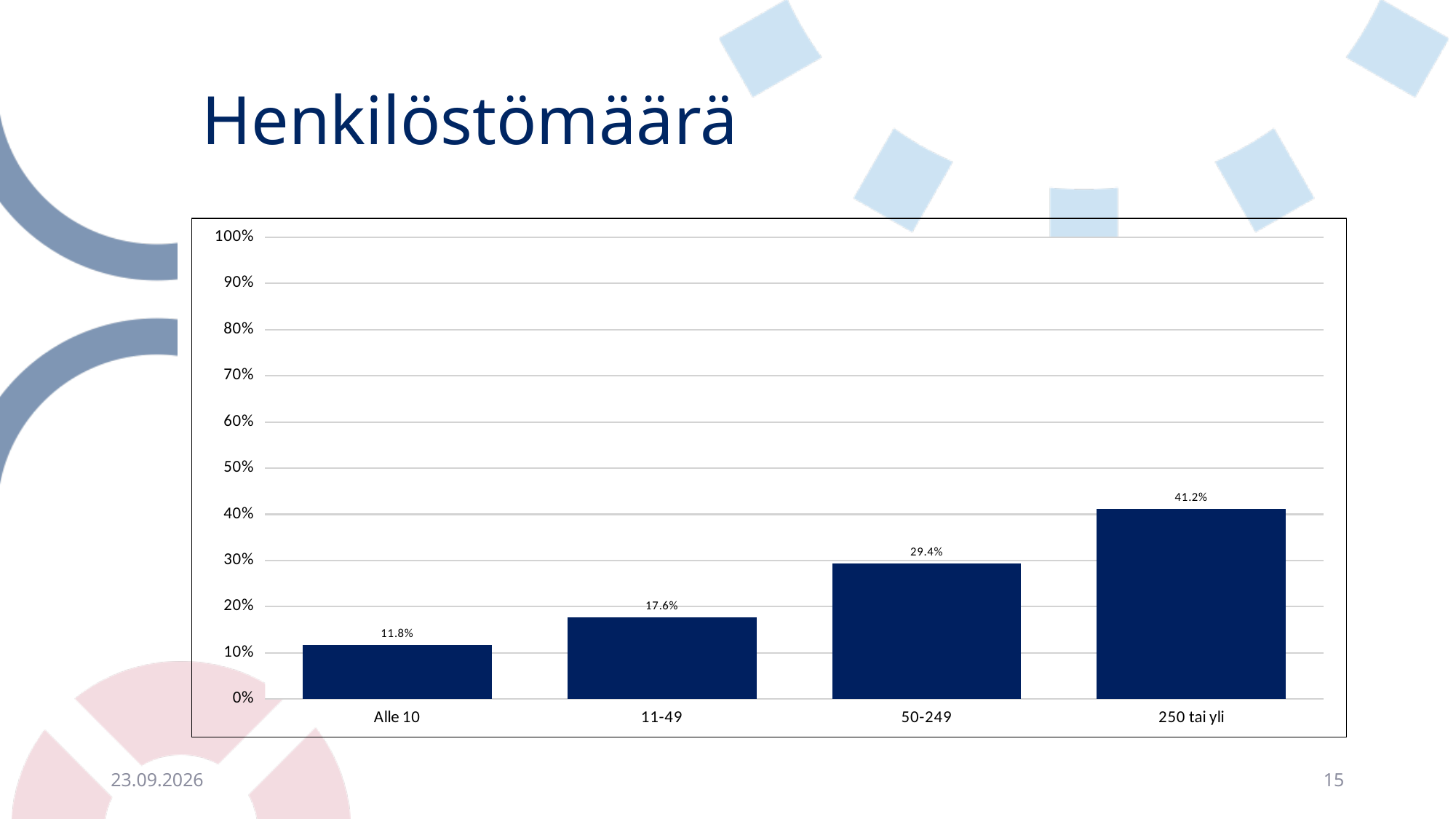
How many categories are shown on the x axis? 4 Which is larger, the value for '50-249' or the value for '11-49'? 50-249 Do the values rise or fall from left to right along the x axis? Rise What is the value for the 'Alle 10' category? 11.8% Which category has the highest value? 250 tai yli What kind of chart is shown on the slide? Bar chart What is the value for the '50-249' category? 29.4% What is the difference between the values for '11-49' and 'Alle 10'? 5.8% What is the value for the '11-49' category? 17.6% Which category has the lowest value? Alle 10 What is the difference between the values for '250 tai yli' and '50-249'? 11.8% What is the value for the '250 tai yli' category? 41.2%